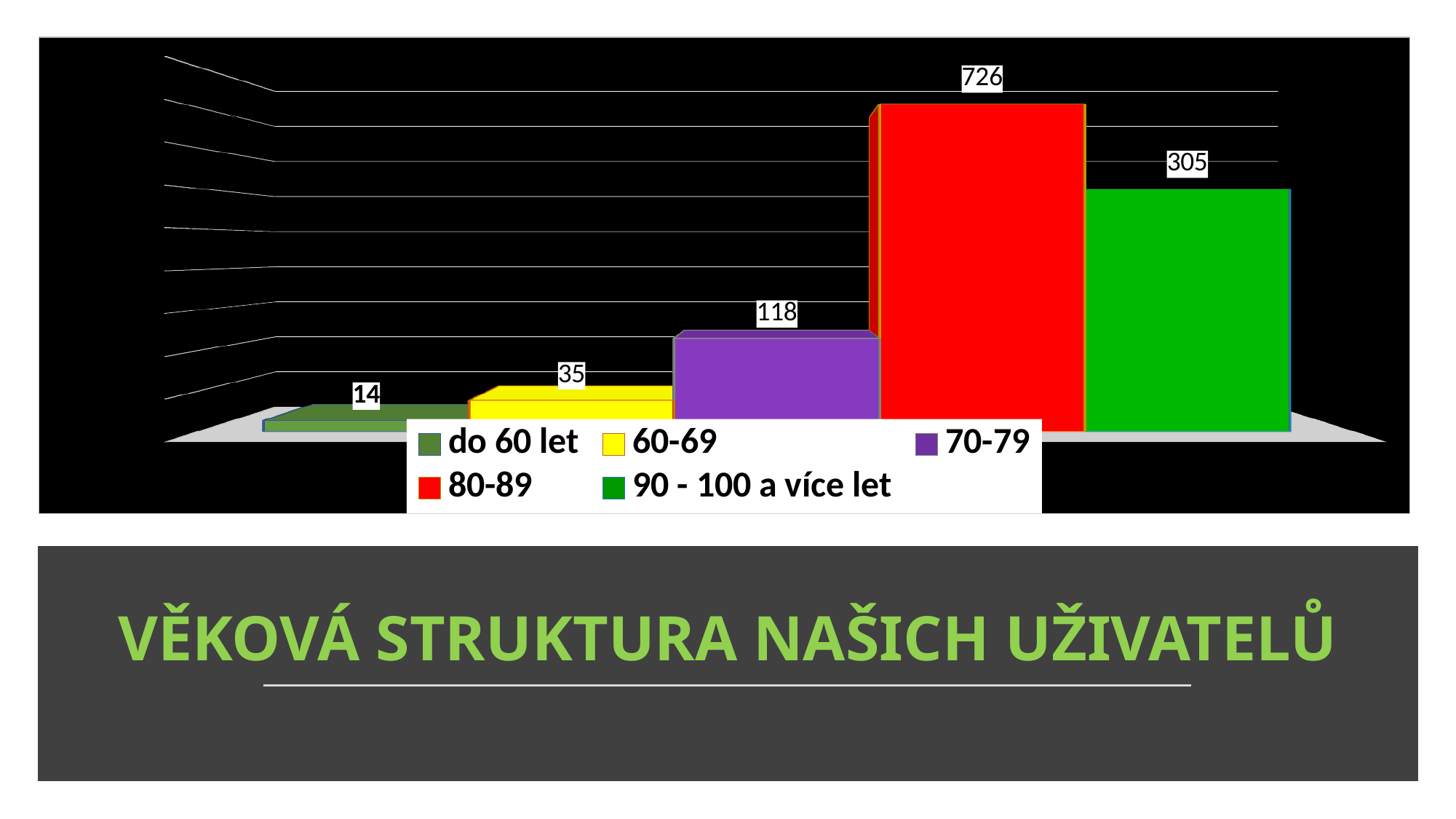
What is the value for the 70-79 age group? 118 Which age group has the lowest value? do 60 let Which is larger, the value for 60-69 or the value for 70-79? 70-79 How many age groups are shown in the chart? 5 What is the difference between the values for 70-79 and 60-69? 83 Which age group has the highest value? 80-89 What is the difference between the values for 80-89 and 90 - 100 a více let? 421 What is the value for the 'do 60 let' age group? 14 What is the value for the 80-89 age group? 726 What is the value for the '90 - 100 a více let' age group? 305 What kind of chart is shown on the slide? bar chart What colour is the bar for the 80-89 age group? red